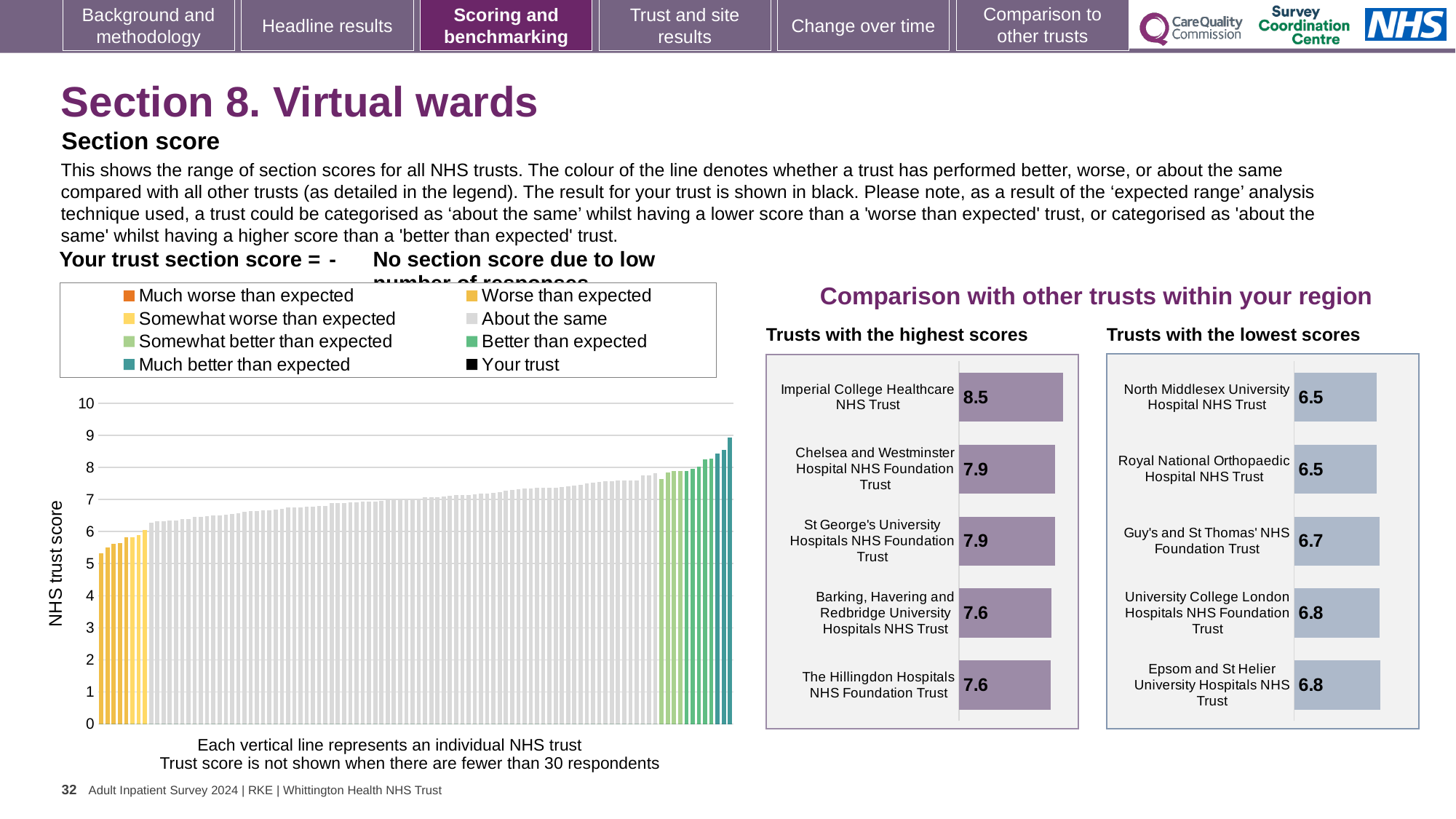
In the large 'NHS trust score' chart on the left, do the bar values rise or fall from left to right? rise In the 'Trusts with the highest scores' chart, what is the score for Imperial College Healthcare NHS Trust? 8.5 What kind of chart is the 'Trusts with the lowest scores' chart? Bar chart How many trusts are shown in the 'Trusts with the highest scores' chart? 5 In the 'Trusts with the lowest scores' chart, what is the score for Epsom and St Helier University Hospitals NHS Trust? 6.8 In the 'Trusts with the highest scores' chart, which trust has the highest score? Imperial College Healthcare NHS Trust How many entries does the legend of the large 'NHS trust score' chart on the left list? 8 In the 'Trusts with the lowest scores' chart, what is the difference between the scores of Guy's and St Thomas' NHS Foundation Trust and North Middlesex University Hospital NHS Trust? 0.2 In the large 'NHS trust score' chart on the left, is the value of the tallest bar greater or less than 8? greater In the 'Trusts with the highest scores' chart, which has the larger score: Imperial College Healthcare NHS Trust or Barking, Havering and Redbridge University Hospitals NHS Trust? Imperial College Healthcare NHS Trust In the 'Trusts with the highest scores' chart, what is the difference between the scores of Imperial College Healthcare NHS Trust and Chelsea and Westminster Hospital NHS Foundation Trust? 0.6 In the 'Trusts with the lowest scores' chart, what is the score for Guy's and St Thomas' NHS Foundation Trust? 6.7